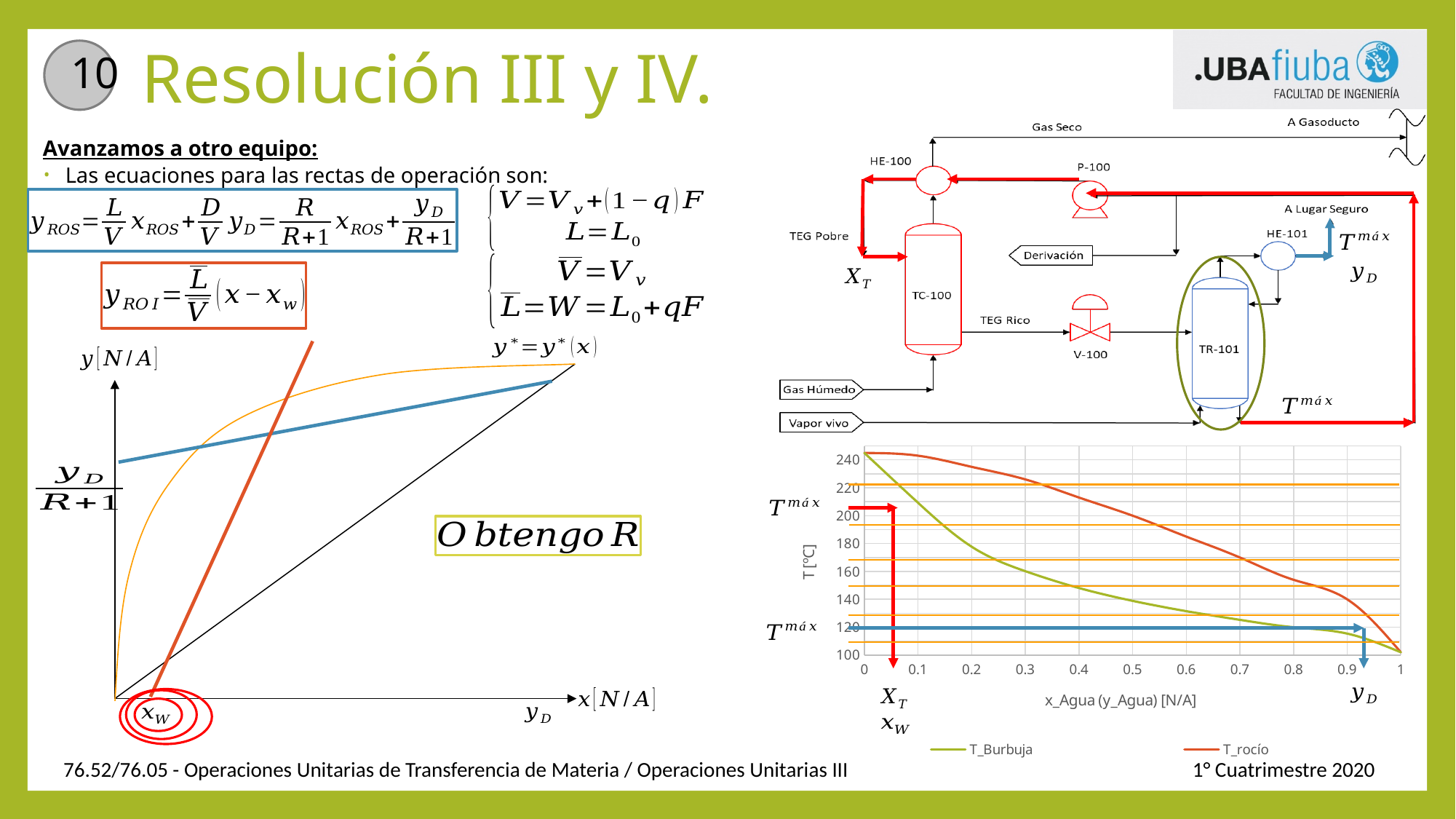
In the bottom-right temperature chart, does the T_rocío curve rise or fall as x_Agua increases from 0 to 1? fall In the bottom-right temperature chart, is the T_rocío value at x_Agua = 0.5 greater or less than 180? greater How many series does the legend of the bottom-right temperature chart list? 2 In the bottom-right temperature chart, does the T_Burbuja curve rise or fall as x_Agua increases from 0 to 1? fall In the bottom-right temperature chart, at x_Agua = 0.5, which series has the higher temperature, T_Burbuja or T_rocío? T_rocío In the bottom-right temperature chart, is the T_Burbuja value at x_Agua = 0.5 greater or less than 160? less What is the highest tick value shown on the vertical T [°C] axis of the bottom-right chart? 240 In the bottom-right temperature chart, which series is drawn in red? T_rocío What kind of chart is shown at the bottom right of the slide (T [°C] versus x_Agua)? line chart In the bottom-right temperature chart, is the T_rocío value at x_Agua = 0.7 greater or less than 160? greater What are the two series named in the legend of the bottom-right temperature chart? T_Burbuja and T_rocío